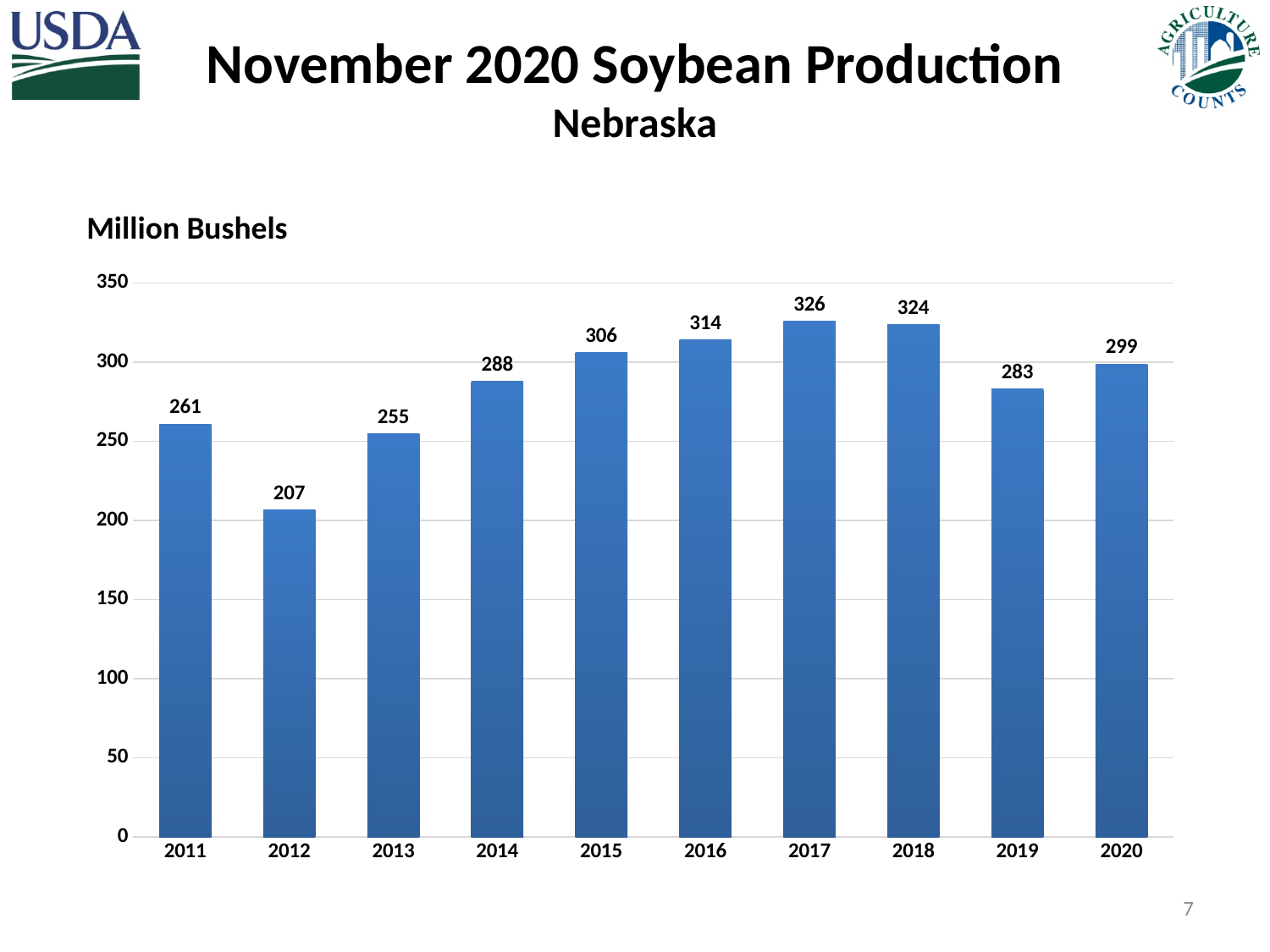
Which year had higher production, 2011 or 2013? 2011 What value is shown for 2014? 288 What is the difference between the 2017 and 2012 values? 119 What unit is the chart's y axis measured in? Million Bushels Which year had the lowest soybean production? 2012 Which year had the highest soybean production? 2017 What kind of chart is shown on the slide? Bar chart Is the value for 2016 greater or less than 300? greater How many years are shown on the chart? 10 Did soybean production rise or fall from 2012 to 2017? Rise What was Nebraska's soybean production in 2020, in million bushels? 299 How much higher is the 2020 value than the 2019 value? 16